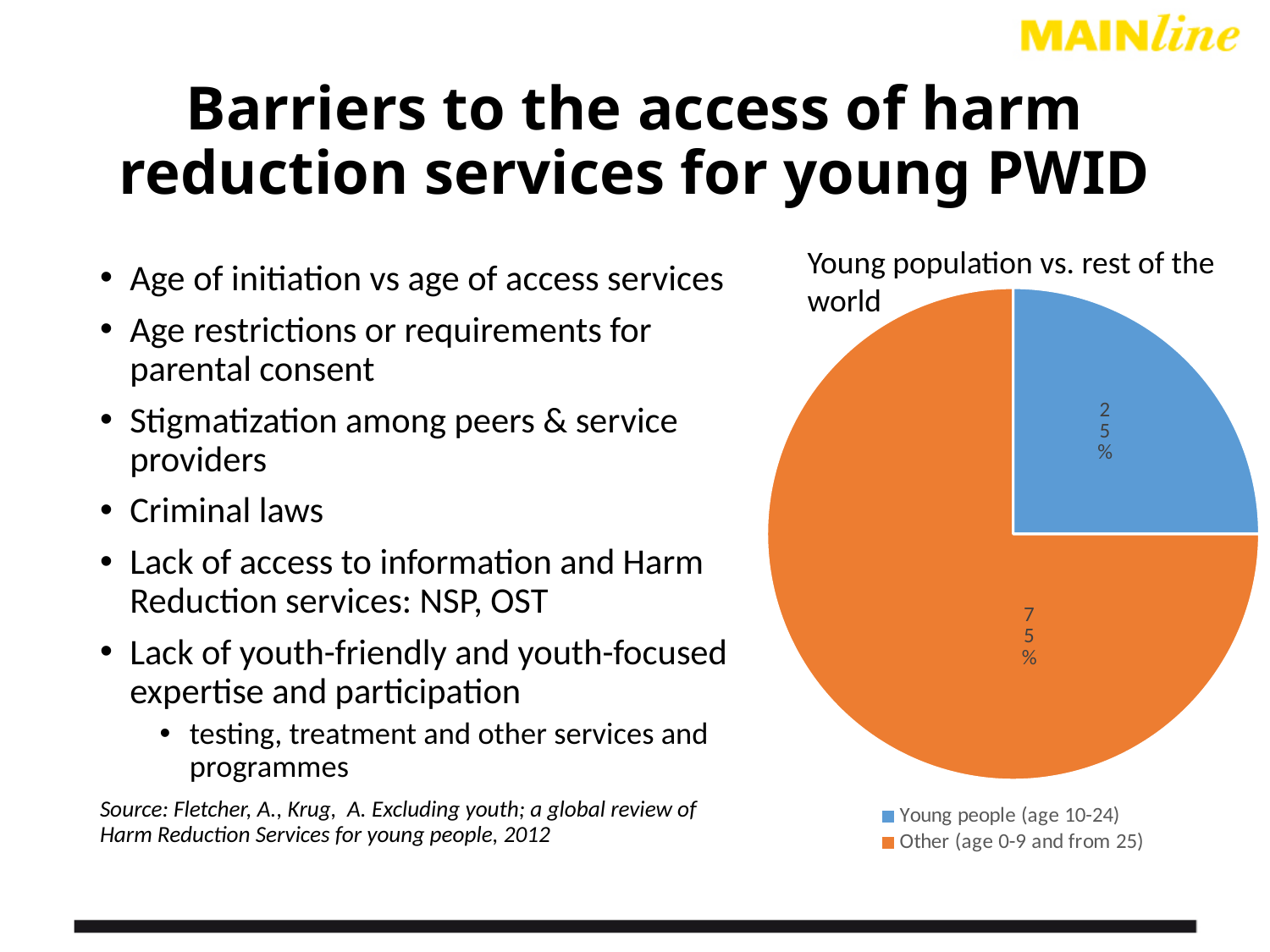
How many slices does the pie chart have? 2 Which slice of the pie is the largest? Other (age 0-9 and from 25) What is the title of the chart? Young population vs. rest of the world How many entries does the legend list? 2 What kind of chart is shown on the slide? pie chart What share of the pie is labelled for Young people (age 10-24)? 25% What is the difference in percentage points between the Other slice and the Young people slice? 50 percentage points What share of the pie is labelled for Other (age 0-9 and from 25)? 75% Which is larger, the Young people (age 10-24) slice or the Other (age 0-9 and from 25) slice? Other (age 0-9 and from 25) Which slice of the pie is the smallest? Young people (age 10-24) What colour is the slice for Young people (age 10-24)? blue